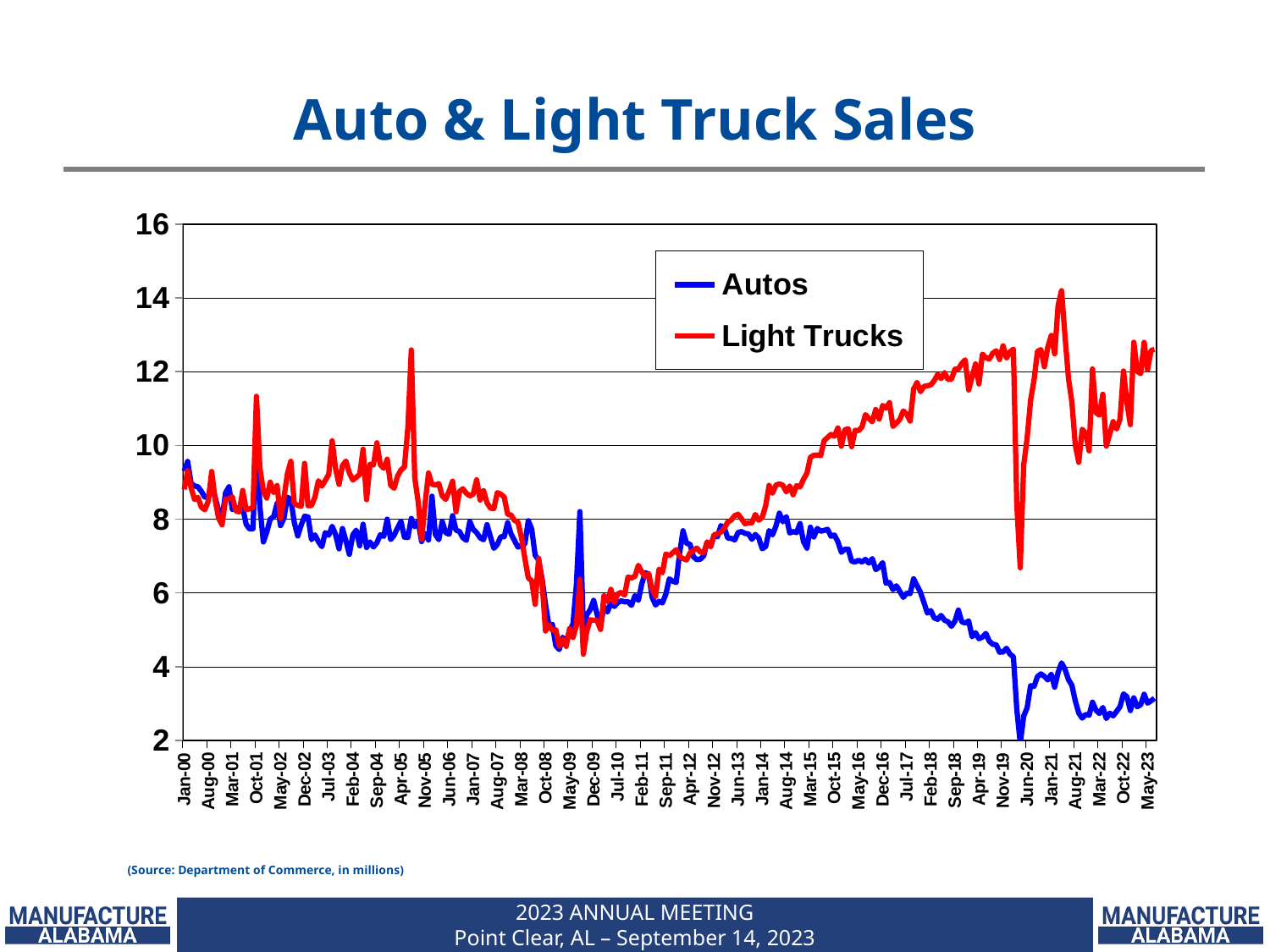
What colour is the Autos line? Blue Is the value for Light Trucks at Jun-20 greater or less than 8? greater Is the value for Autos at May-23 greater or less than 4? less Which series is higher at Jan-14, Autos or Light Trucks? Light Trucks Which series reaches the highest value anywhere on the chart? Light Trucks What kind of chart is shown on the slide? Line chart How many series does the legend list? 2 What is the title of the chart? Auto & Light Truck Sales Is the value for Autos at Jan-00 greater or less than 8? greater Do the Light Trucks values generally rise or fall from Jan-10 to Jan-20? Rise Do the Autos values generally rise or fall from Jan-14 to May-23? Fall